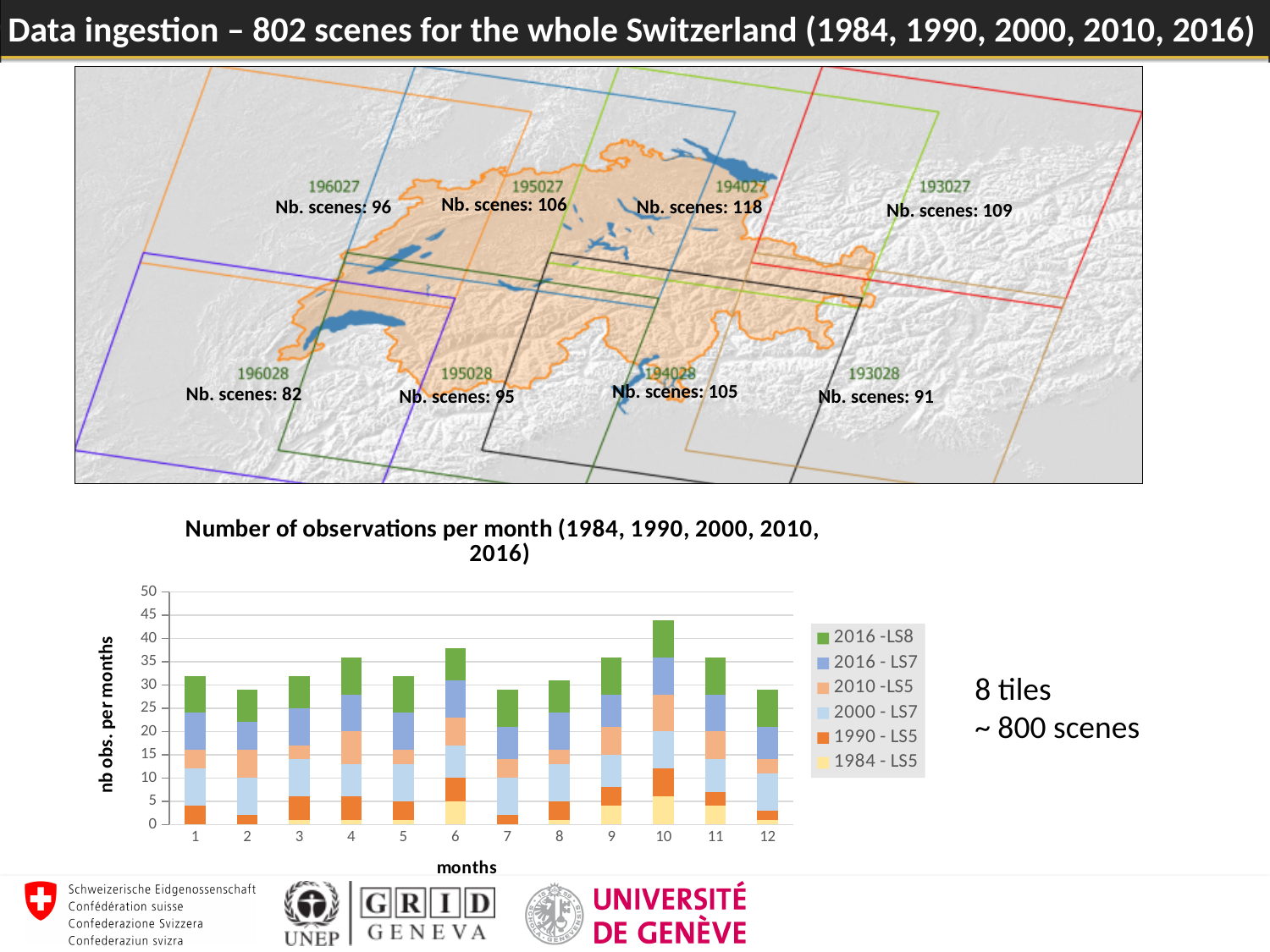
Is the total number of observations for month 12 greater or less than 35? less Which month has a larger total number of observations, month 6 or month 12? 6 How many series does the legend of the bar chart list? 6 What is the title of the bar chart? Number of observations per month (1984, 1990, 2000, 2010, 2016) Is the total number of observations for month 8 greater or less than 35? less What is the label of the y axis of the bar chart? nb obs. per months Which month has a larger total number of observations, month 10 or month 2? 10 How many months (categories) are shown on the x axis of the bar chart? 12 Which month has the highest total number of observations in the bar chart? 10 Is the total number of observations for month 10 greater or less than 40? greater What kind of chart is shown on the slide? Stacked bar chart